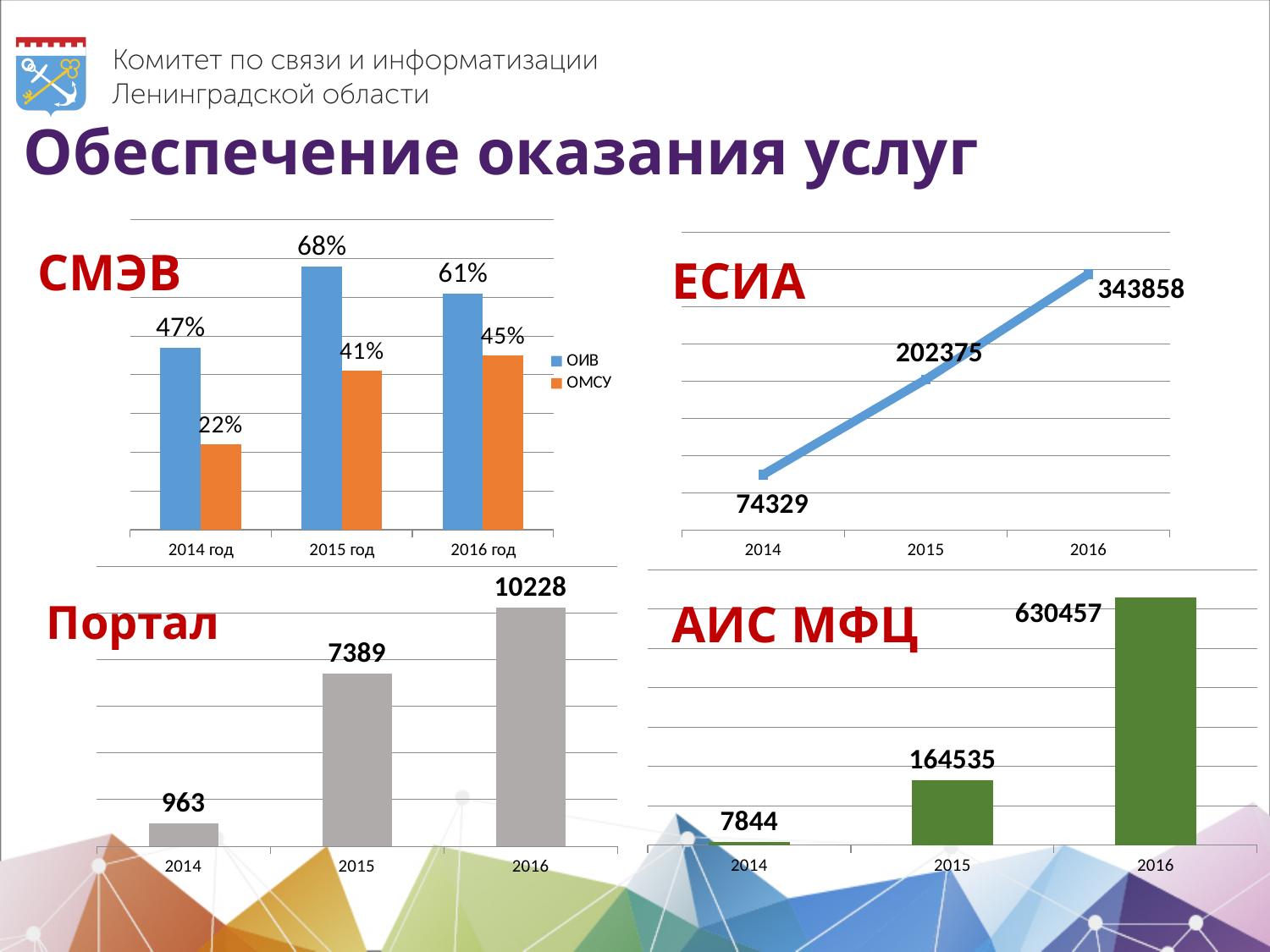
In the Портал chart, what is the value for 2014? 963 In the Портал chart, what is the difference between 2016 and 2015? 2839 In the ЕСИА chart, what kind of chart is shown? line chart In the СМЭВ chart, what is the value for ОИВ in 2015 год? 68% In the СМЭВ chart, what is the difference between ОИВ and ОМСУ in 2016 год? 16% In the АИС МФЦ chart, which year has the lowest value? 2014 In the ЕСИА chart, do the values rise or fall from 2014 to 2016? rise In the АИС МФЦ chart, what is the value for 2016? 630457 In the ЕСИА chart, what is the value for 2015? 202375 In the СМЭВ chart, how many series does the legend list? 2 In the СМЭВ chart, which year has the highest ОИВ value? 2015 год In the СМЭВ chart, what is the value for ОМСУ in 2014 год? 22%